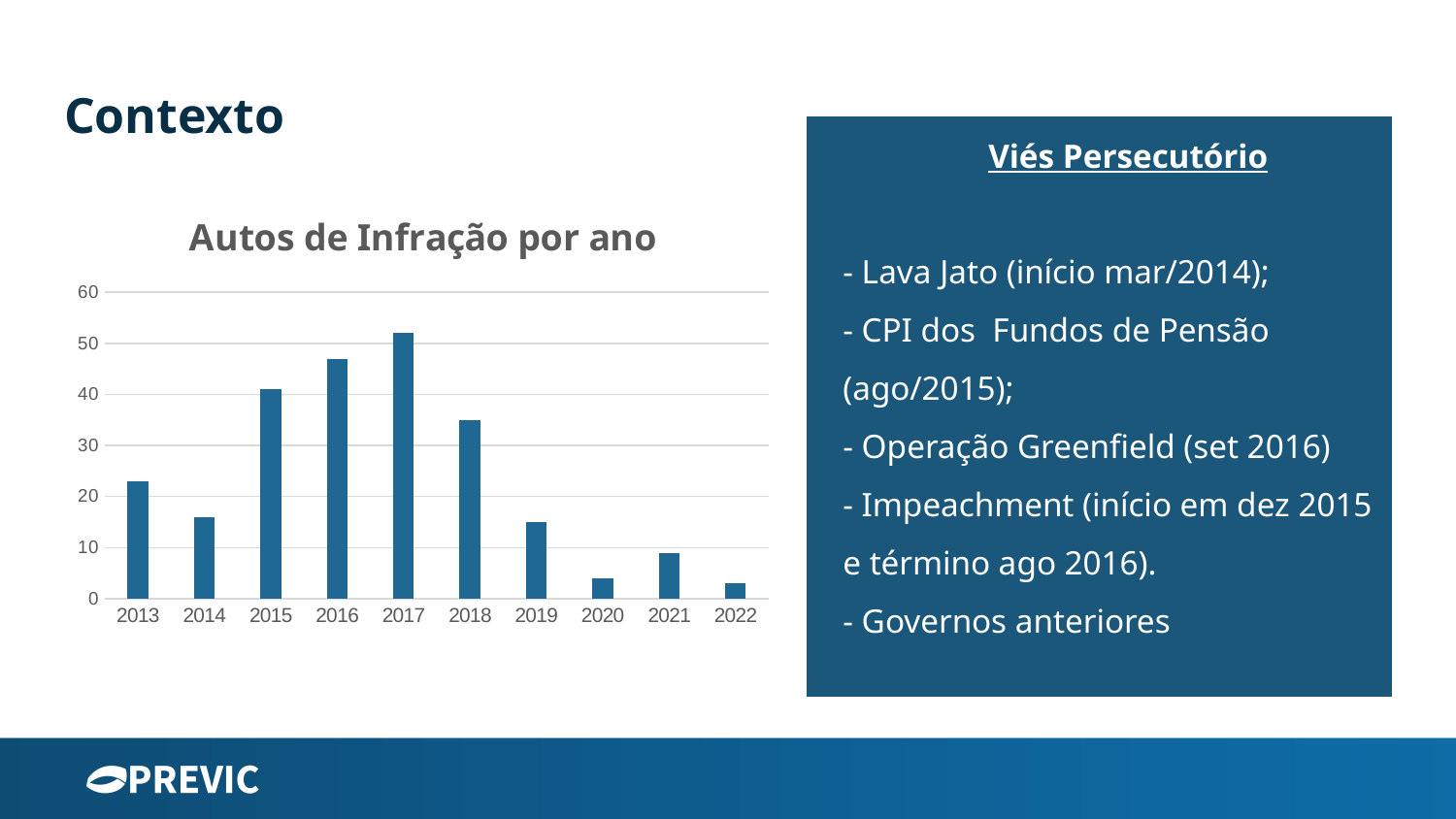
Which year has the larger value, 2019 or 2021? 2019 Do the values rise or fall from 2017 to 2020? fall Is the value for 2013 greater or less than 20? greater Is the value for 2018 greater or less than 30? greater What type of chart is shown under the title "Autos de Infração por ano"? bar chart Is the value for 2017 greater or less than 50? greater How many years are shown on the x axis of the "Autos de Infração por ano" chart? 10 Which year has the highest value in the "Autos de Infração por ano" chart? 2017 Which year has the larger value, 2015 or 2018? 2015 What is the title of the chart on the slide? Autos de Infração por ano